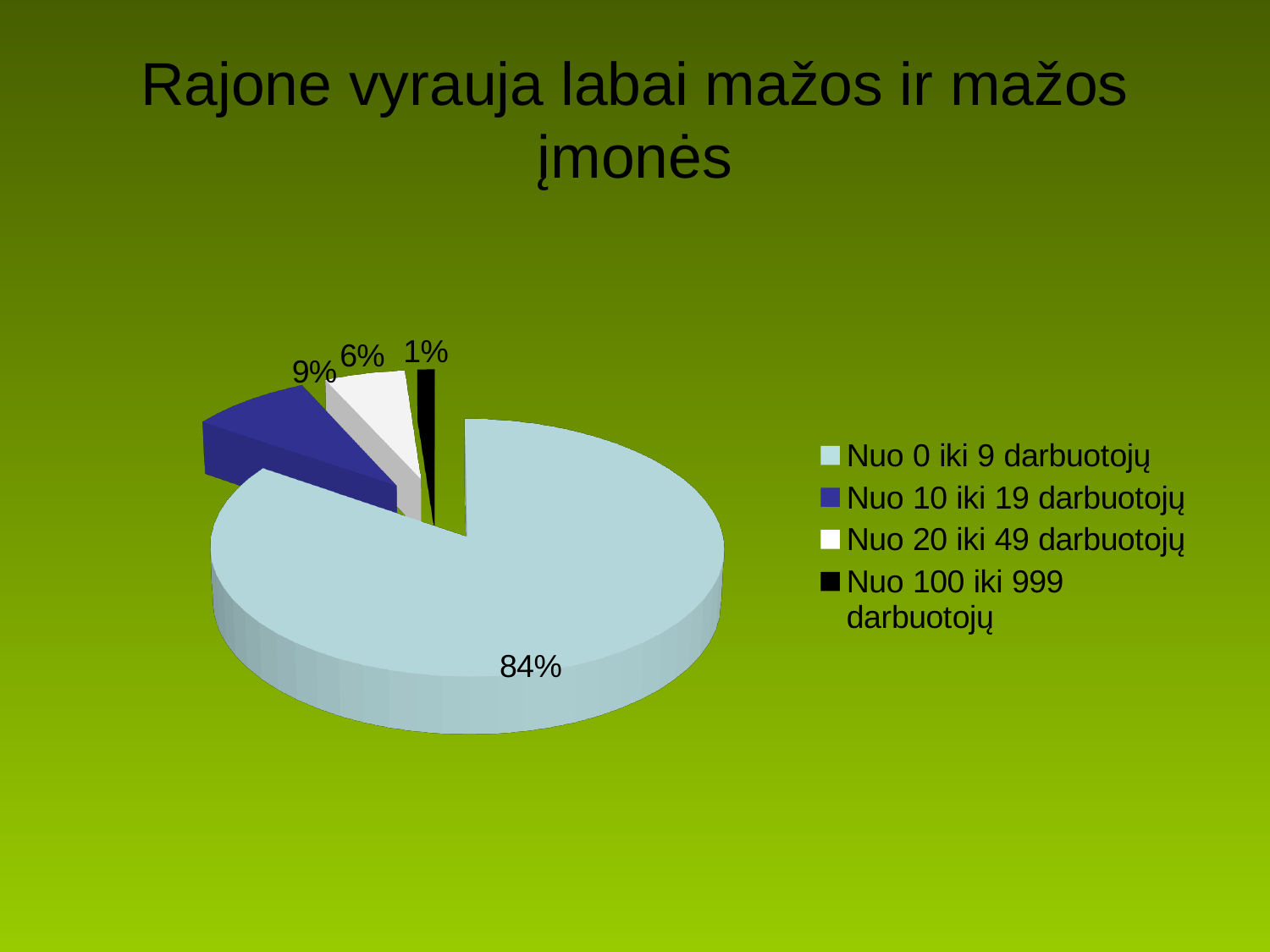
What colour is the slice for 'Nuo 10 iki 19 darbuotojų'? Dark blue What share of the pie does 'Nuo 10 iki 19 darbuotojų' have? 9% What share of the pie does 'Nuo 20 iki 49 darbuotojų' have? 6% What is the difference in percentage points between 'Nuo 0 iki 9 darbuotojų' and 'Nuo 10 iki 19 darbuotojų'? 75 What is the difference in percentage points between 'Nuo 10 iki 19 darbuotojų' and 'Nuo 20 iki 49 darbuotojų'? 3 How many categories does the pie chart show? 4 Which category has the smallest slice of the pie? Nuo 100 iki 999 darbuotojų Which category has the largest slice of the pie? Nuo 0 iki 9 darbuotojų What kind of chart is shown on the slide? Pie chart What share of the pie does 'Nuo 100 iki 999 darbuotojų' have? 1% Which is larger, the slice for 'Nuo 20 iki 49 darbuotojų' or the slice for 'Nuo 100 iki 999 darbuotojų'? Nuo 20 iki 49 darbuotojų